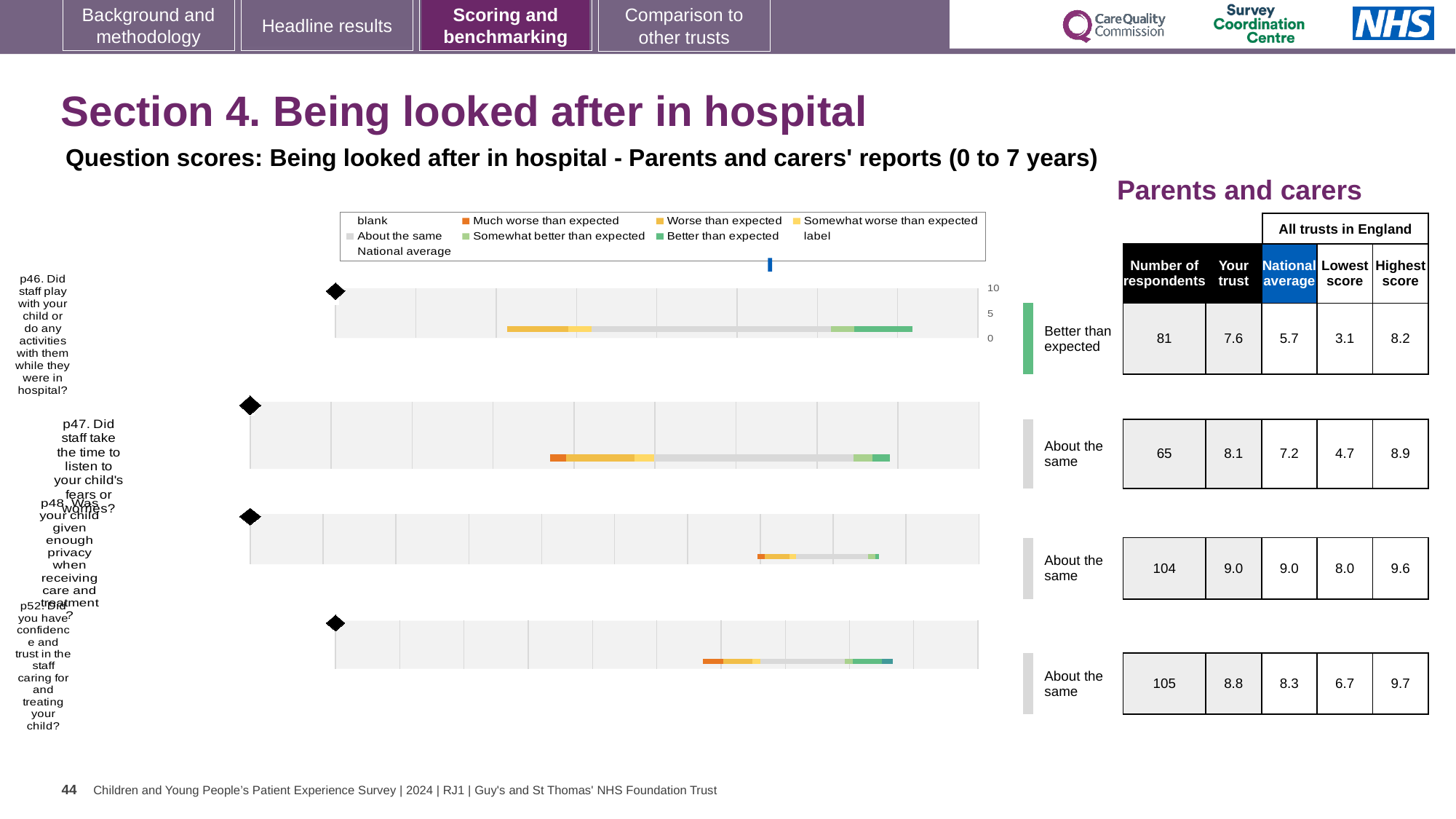
For the p46 chart, what is the difference between the 'Your trust' score and the national average? 1.9 What kind of chart is used to show the question scores on this slide? bar chart Which of the four charted questions has the highest 'Your trust' score? p48 Which of the four charted questions has the fewest respondents? p47 For the p48 chart (Was your child given enough privacy...), what is the lowest score among all trusts in England? 8.0 For the p52 chart (Did you have confidence and trust in the staff...), what is the highest score among all trusts in England? 9.7 For the p46 chart, what is the national average score? 5.7 For the p47 chart, which is larger: the 'Your trust' score or the national average? Your trust For the p47 chart (Did staff take the time to listen to your child's fears or worries?), how many respondents are there? 65 What benchmark category is shown next to the p46 chart? Better than expected How many survey questions are charted on this slide? 4 For the p46 chart (Did staff play with your child...), what is the 'Your trust' score? 7.6